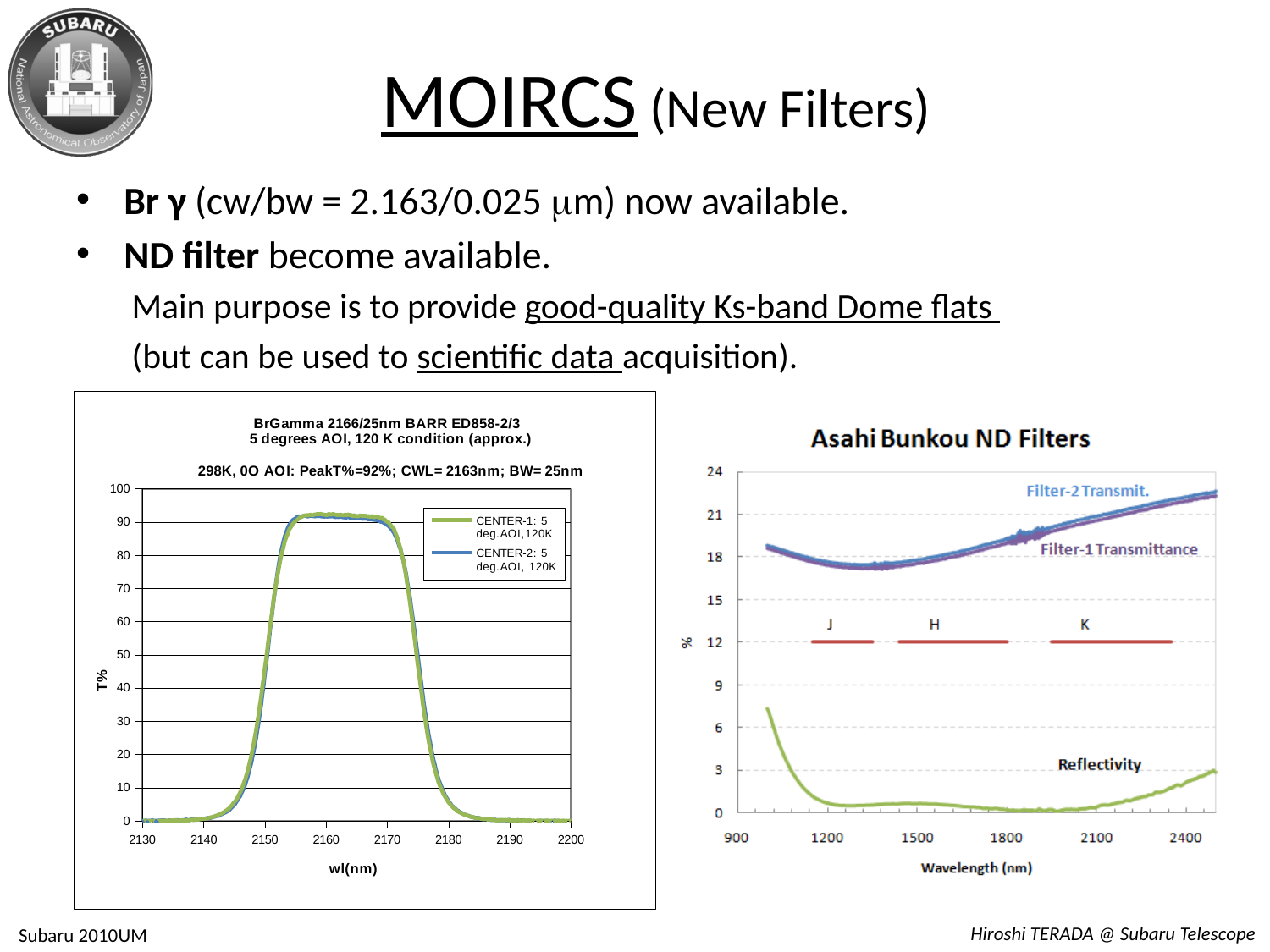
In the left BrGamma chart, is the transmission (T%) at 2160 nm greater or less than 90? greater In the right 'Asahi Bunkou ND Filters' chart, is the Filter-2 transmittance at 2400 nm greater or less than 21? greater In the right 'Asahi Bunkou ND Filters' chart, is the Reflectivity at 1800 nm greater or less than 3? less In the right 'Asahi Bunkou ND Filters' chart, does the Reflectivity curve rise or fall between 900 nm and 1200 nm? fall What is the title of the right chart? Asahi Bunkou ND Filters How many series does the legend of the left BrGamma chart list? 2 What is the x-axis label of the left BrGamma chart? wl(nm) What peak T% is stated in the subtitle of the left BrGamma chart? 92% In the right 'Asahi Bunkou ND Filters' chart, which is higher at 2400 nm: Filter-2 Transmit. or Reflectivity? Filter-2 Transmit. What kind of chart is the left chart titled 'BrGamma 2166/25nm BARR ED858-2/3'? line chart